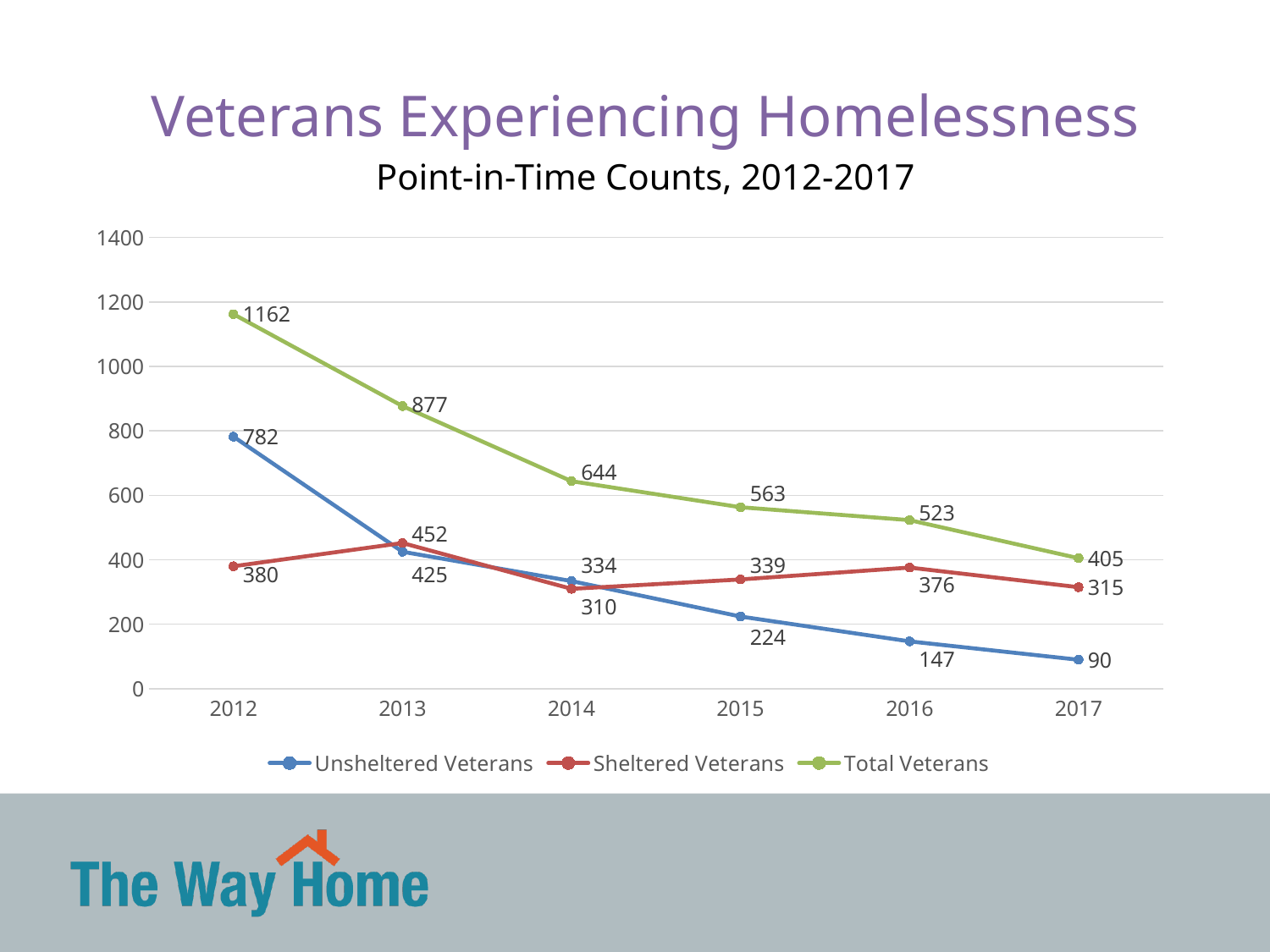
What was the number of Unsheltered Veterans in 2017? 90 Does the Total Veterans line rise or fall from 2012 to 2017? Fall Is the Total Veterans value for 2014 greater or less than 600? greater What was the number of Sheltered Veterans in 2016? 376 What is the difference between the Total Veterans count in 2012 and in 2017? 757 Which was larger in 2013, Unsheltered Veterans or Sheltered Veterans? Sheltered Veterans How many years are shown on the x axis? 6 In which year was the Unsheltered Veterans count highest? 2012 What kind of chart is shown on the slide? Line chart How many series does the legend list? 3 In which year was the Sheltered Veterans count lowest? 2014 What was the number of Total Veterans in 2012? 1162